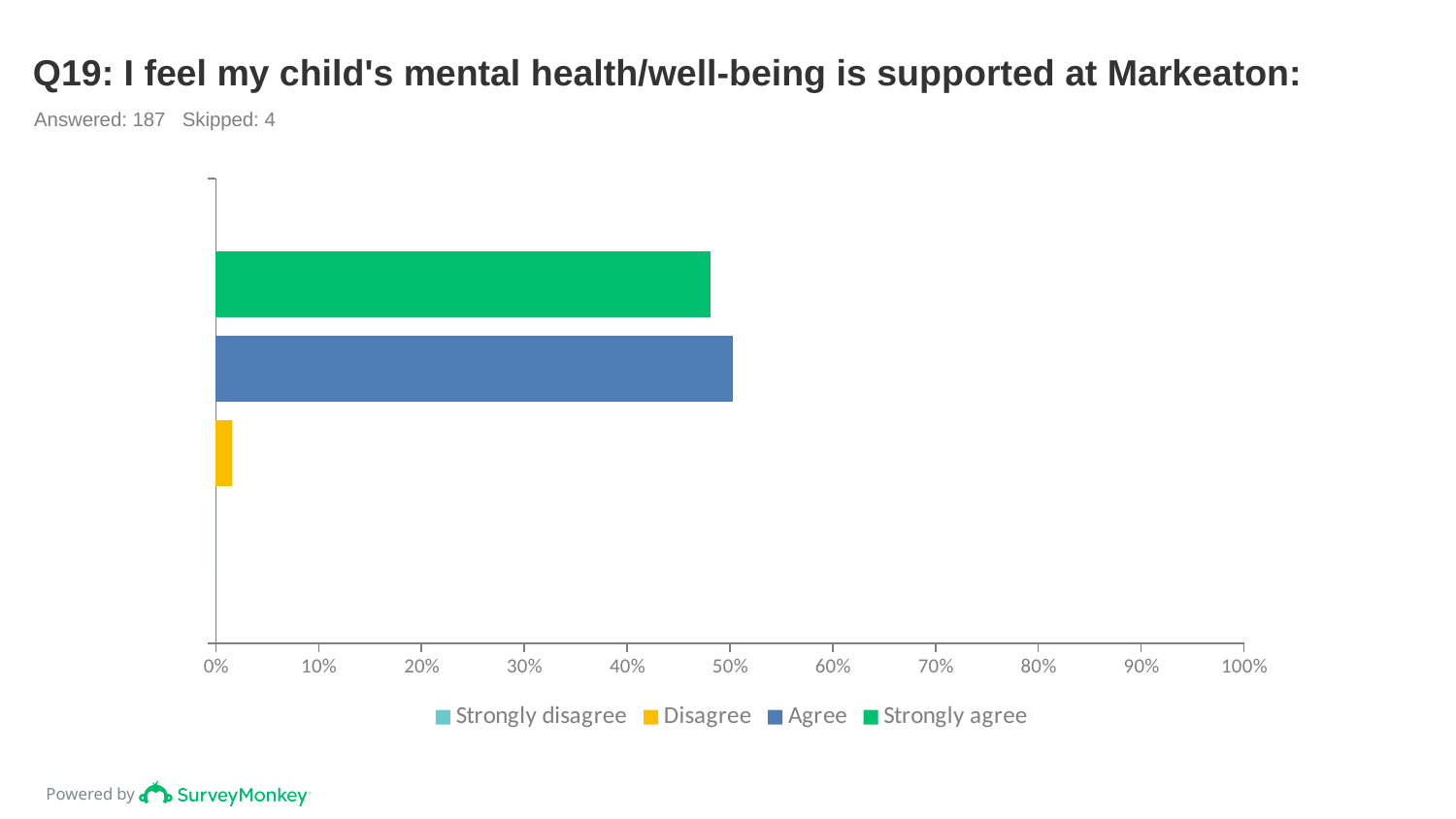
How many respondents answered the question according to the slide? 187 What kind of chart is shown on the slide? bar chart Which is larger, the value for Disagree or the value for Agree? Agree What is the title of the chart? Q19: I feel my child's mental health/well-being is supported at Markeaton: Is the value for Agree greater or less than 40%? greater How many series does the legend list? 4 Is the value for Strongly agree greater or less than 40%? greater Is the value for Strongly agree greater or less than 30%? greater Which is larger, the value for Strongly agree or the value for Disagree? Strongly agree